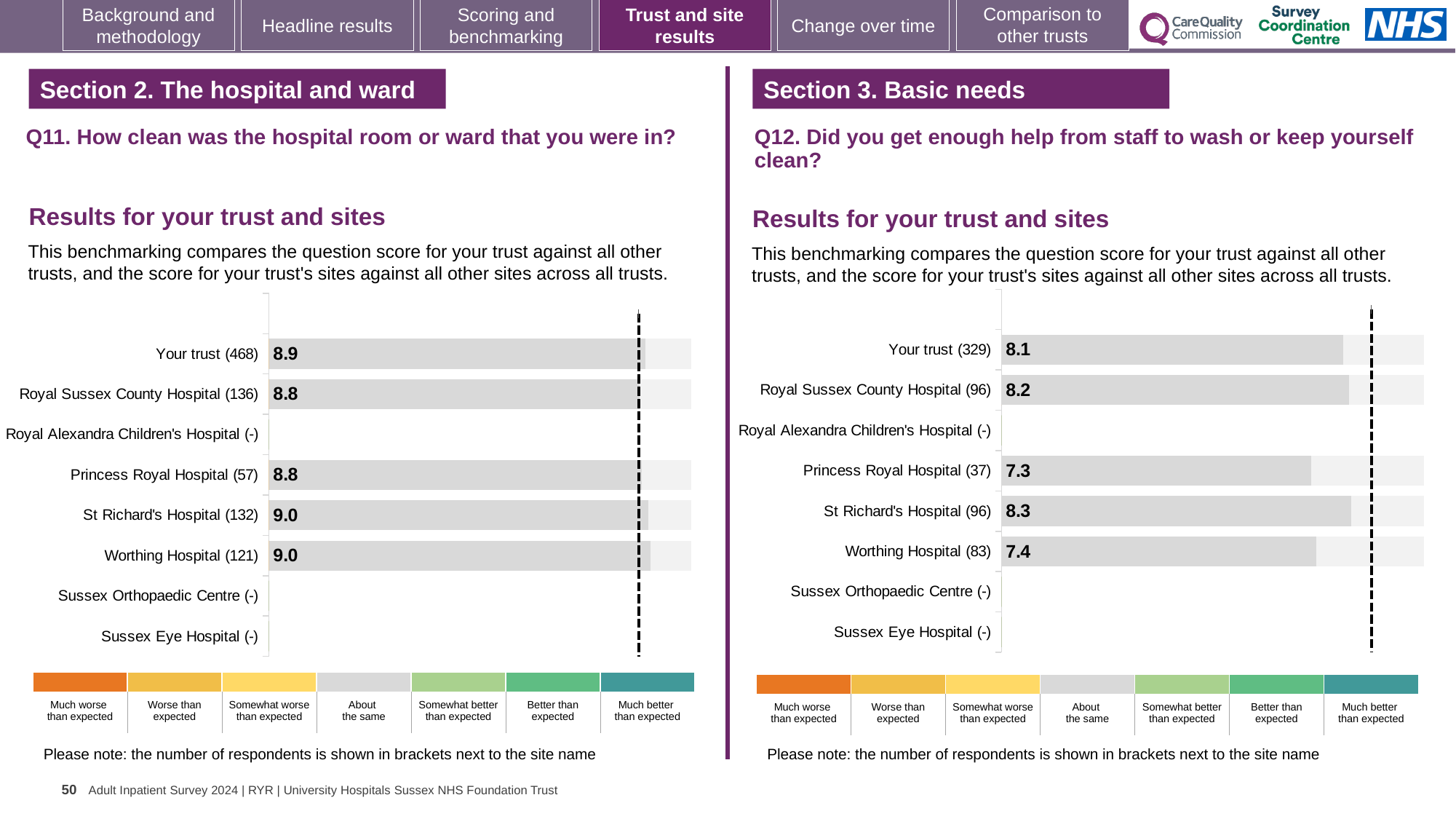
On the Q12 chart (right), what is the score for Royal Sussex County Hospital? 8.2 How many respondents are shown in brackets for Your trust on the Q12 chart (right)? 329 How many site or trust labels are listed on the Q11 chart (left)? 8 On the Q12 chart (right), which site has the highest score? St Richard's Hospital What kind of chart is used for the Q12 results (right)? Bar chart On the Q11 chart (left), what is the score for Your trust? 8.9 On the Q12 chart (right), what is the difference between the scores for St Richard's Hospital and Princess Royal Hospital? 1.0 On the Q12 chart (right), what is the score for Worthing Hospital? 7.4 On the Q11 chart (left), what is the difference between the scores for Your trust and Royal Sussex County Hospital? 0.1 On the Q11 chart (left), what is the score for Princess Royal Hospital? 8.8 On the Q11 chart (left), what is the score for St Richard's Hospital? 9.0 On the Q12 chart (right), which is larger, the score for St Richard's Hospital or Princess Royal Hospital? St Richard's Hospital